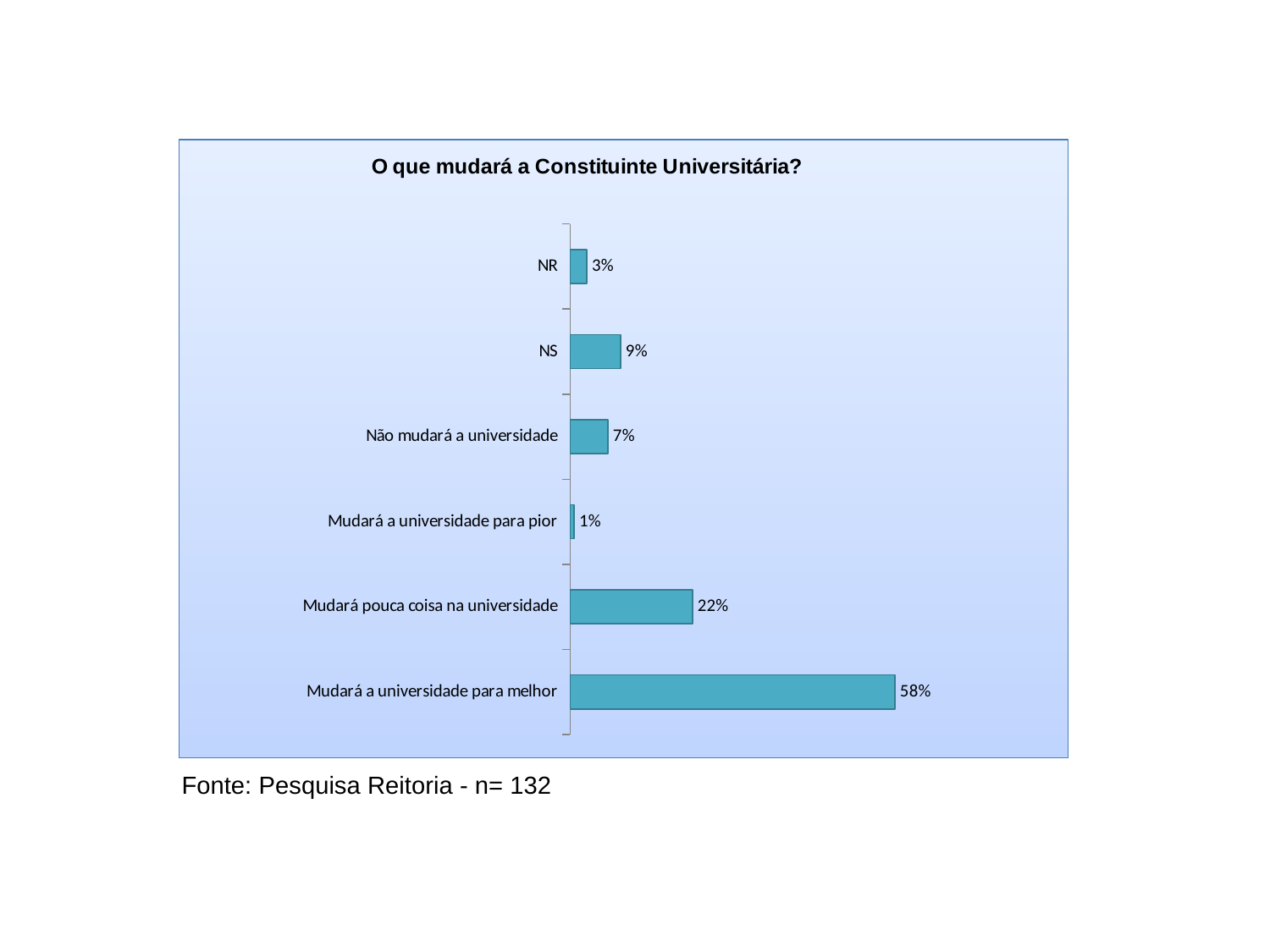
What kind of chart is shown on the slide? Bar chart What is the title of the chart? O que mudará a Constituinte Universitária? What is the difference between "NS" and "Não mudará a universidade"? 2% Which category has the lowest value? Mudará a universidade para pior Which is larger, the value for "NS" or the value for "NR"? NS What is the value for "NS"? 9% How many categories are shown in the chart? 6 What is the value for "Não mudará a universidade"? 7% What is the value for "Mudará pouca coisa na universidade"? 22% Which category has the highest value? Mudará a universidade para melhor What is the value for "Mudará a universidade para melhor"? 58% What is the difference between "Mudará a universidade para melhor" and "Mudará pouca coisa na universidade"? 36%